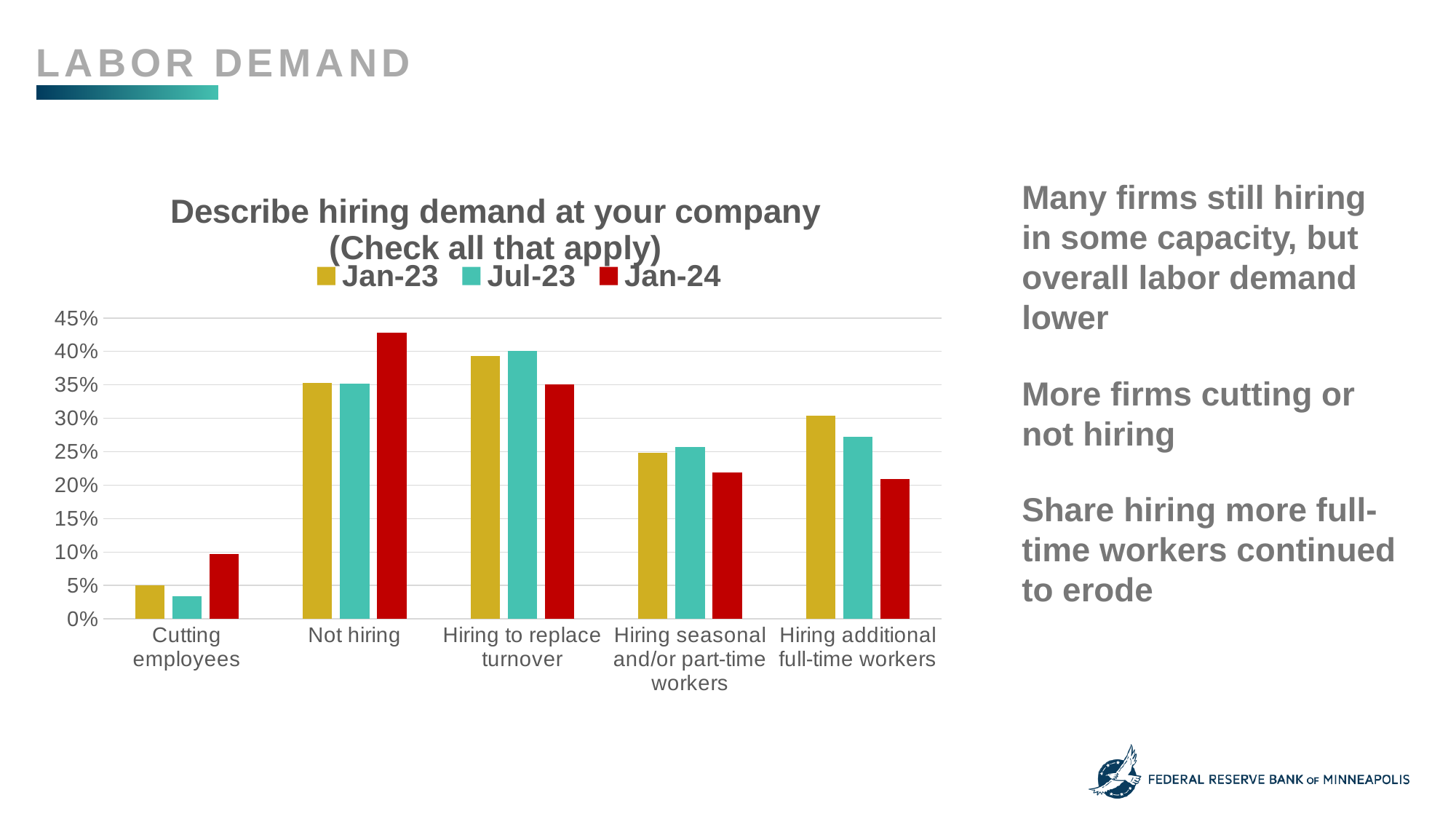
How many series does the legend list? 3 Is the Jul-23 value for Hiring to replace turnover greater or less than 35%? greater For Hiring additional full-time workers, which is larger: the Jan-23 value or the Jan-24 value? Jan-23 Which category has the lowest Jan-24 value? Cutting employees For Cutting employees, which is larger: the Jul-23 value or the Jan-24 value? Jan-24 Is the Jan-23 value for Cutting employees greater or less than 10%? less What kind of chart is shown on the slide? Bar chart For Hiring additional full-time workers, do the values rise or fall from Jan-23 to Jul-23 to Jan-24? fall Which category has the highest Jan-24 value? Not hiring How many categories are shown on the x axis? 5 What are the three series listed in the legend? Jan-23, Jul-23, Jan-24 Is the Jan-24 value for Not hiring greater or less than 40%? greater